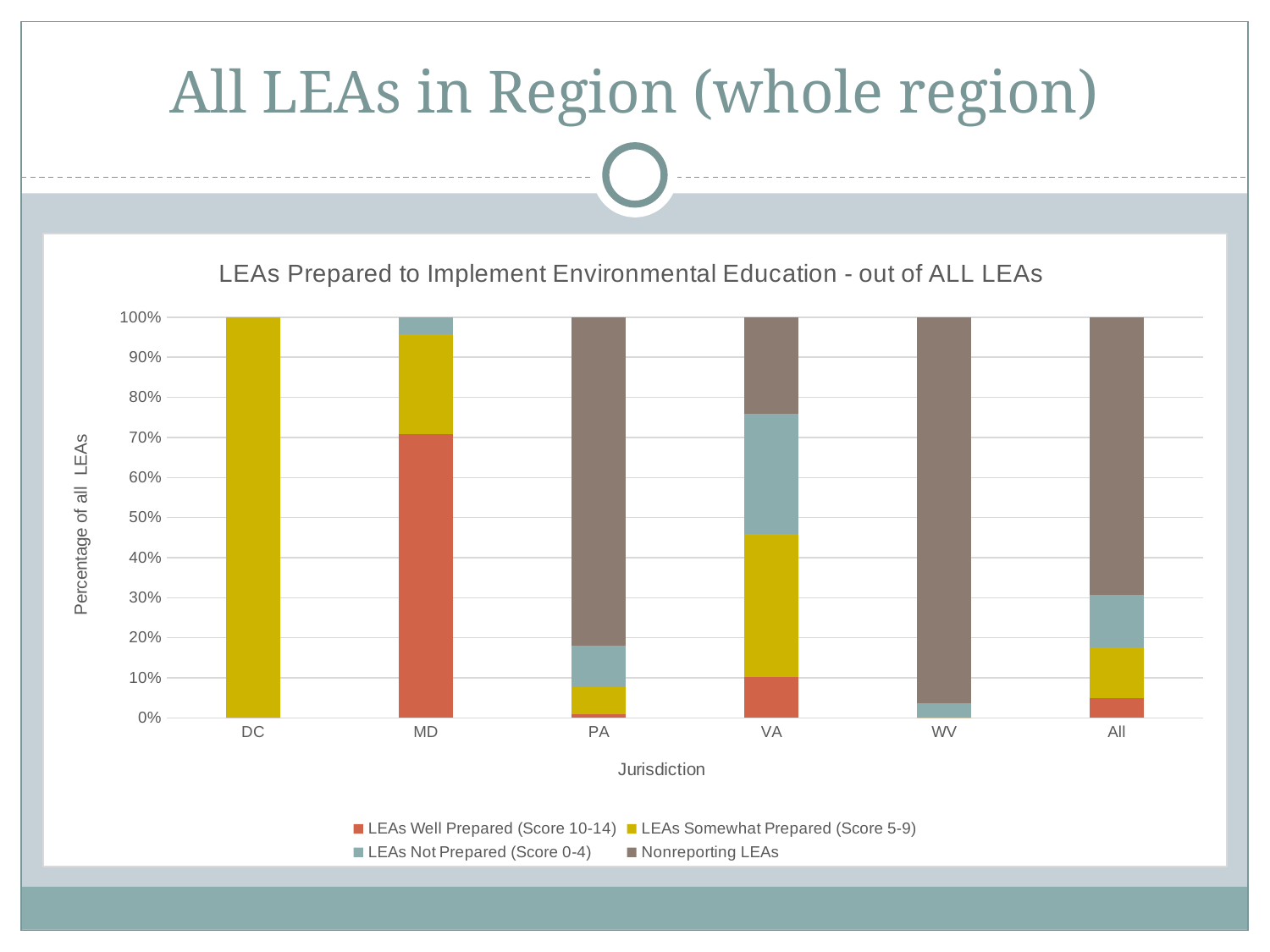
Which jurisdiction has the largest share of Well Prepared LEAs (Score 10-14)? MD What is the label on the y axis? Percentage of all LEAs Is the share of Nonreporting LEAs larger in PA or in VA? PA Is the share of Nonreporting LEAs in PA greater or less than 70%? greater What is the title of the chart? LEAs Prepared to Implement Environmental Education - out of ALL LEAs What percentage of LEAs in DC are Somewhat Prepared (Score 5-9)? 100% Is the share of Nonreporting LEAs in VA greater or less than 30%? less Is the share of Nonreporting LEAs in WV greater or less than 90%? greater What kind of chart is shown on the slide? Stacked bar chart How many jurisdictions are shown on the x axis? 6 How many series does the legend list? 4